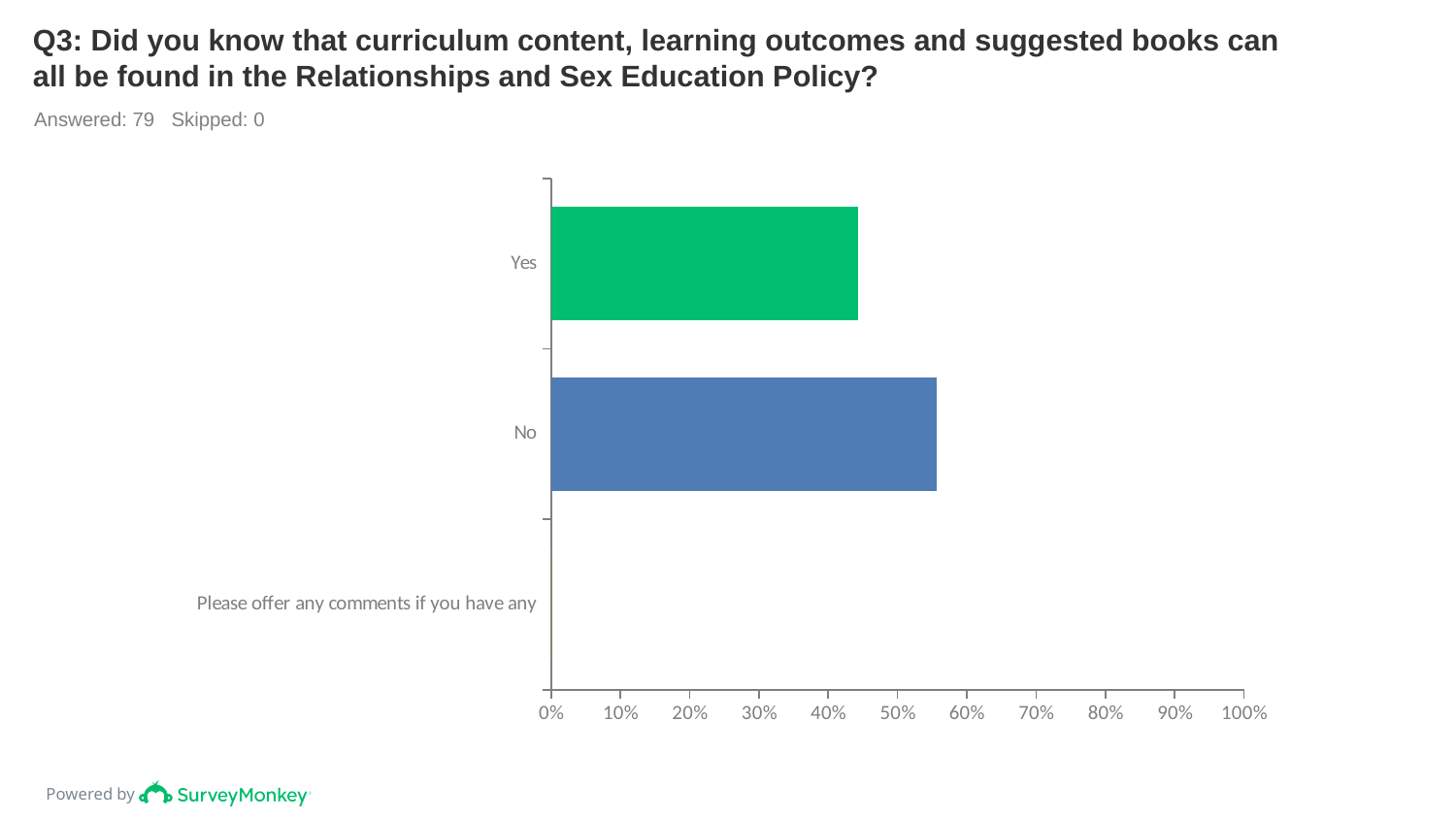
Is the value for No greater or less than 50%? greater How many respondents answered this question according to the slide? 79 Which is larger, the value for Yes or the value for No? No Which category has the lowest value? Please offer any comments if you have any Is the value for Yes greater or less than 40%? greater Is the value for No greater or less than 60%? less What kind of chart is shown on the slide? bar chart What is the highest value shown on the horizontal axis? 100% How many categories are shown on the chart's vertical axis? 3 Which category has the highest value? No What colour is the bar for Yes? green